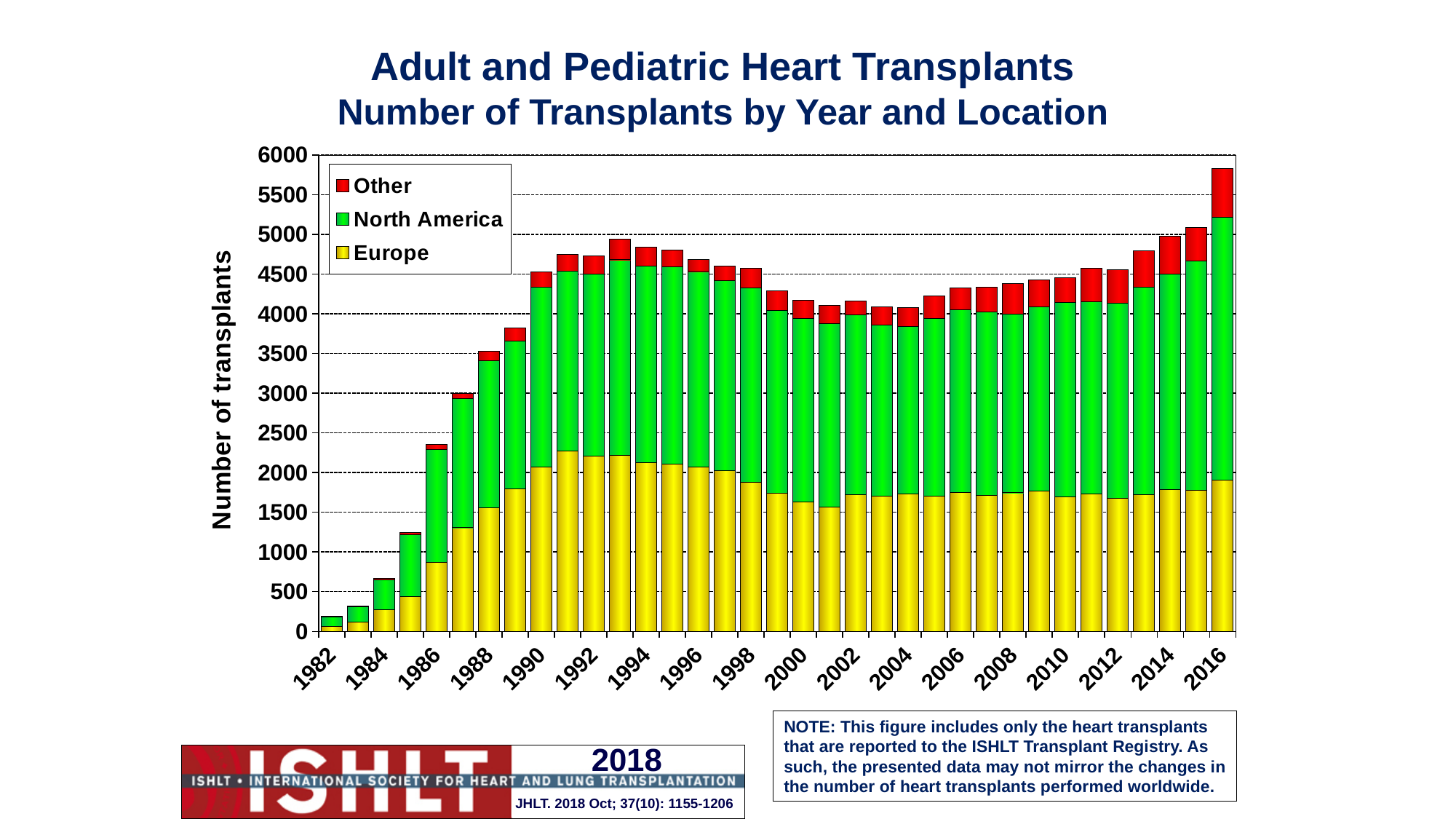
Do the total numbers of transplants rise or fall from 2004 to 2016? rise How many series does the legend list? 3 Which year has the lowest total number of transplants? 1982 Which colour represents Europe in the chart? Yellow Is the total number of transplants in 2000 greater or less than 4500? less What kind of chart is shown on the slide? Stacked bar chart Which year has the highest total number of transplants? 2016 Which year has the larger total number of transplants, 1990 or 2000? 1990 Is the total number of transplants in 2016 greater or less than 5500? greater Is the Europe value for 1986 greater or less than 1000? less What is the label of the vertical axis? Number of transplants